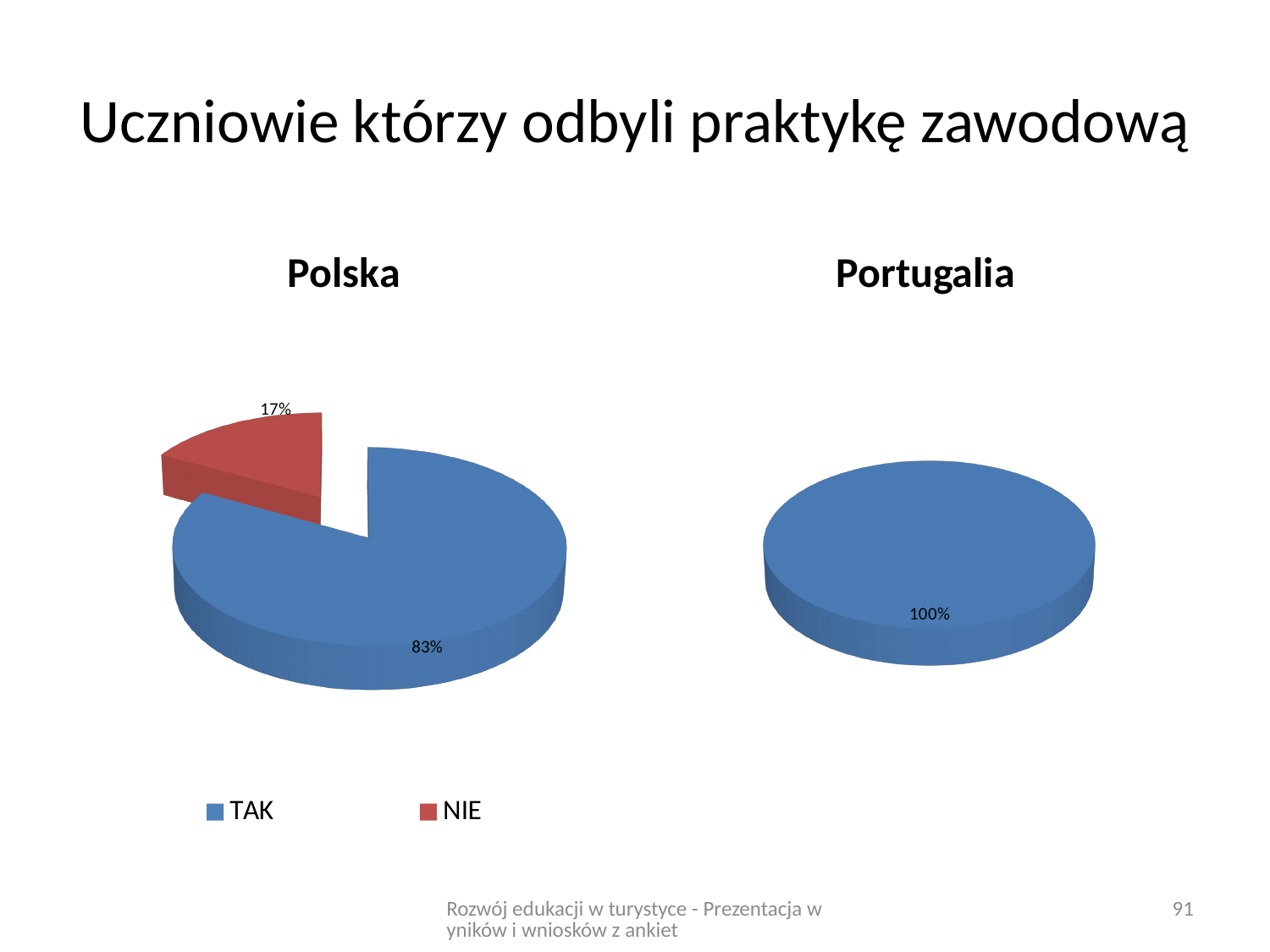
How many slices does the Polska chart have? 2 In the Polska chart, what share of the pie is NIE? 17% In the Polska chart, what share of the pie is TAK? 83% What kind of chart is the Portugalia chart? Pie chart In the Polska chart, which slice is the smallest? NIE What kind of chart is the Polska chart? Pie chart In the Polska chart, what is the difference between the TAK and NIE shares? 66% In the Polska chart, which is larger, TAK or NIE? TAK In the Polska chart, which slice is the largest? TAK Which colour represents NIE in the legend? Red In the Portugalia chart, what share of the pie is TAK? 100% How many entries does the legend list? 2